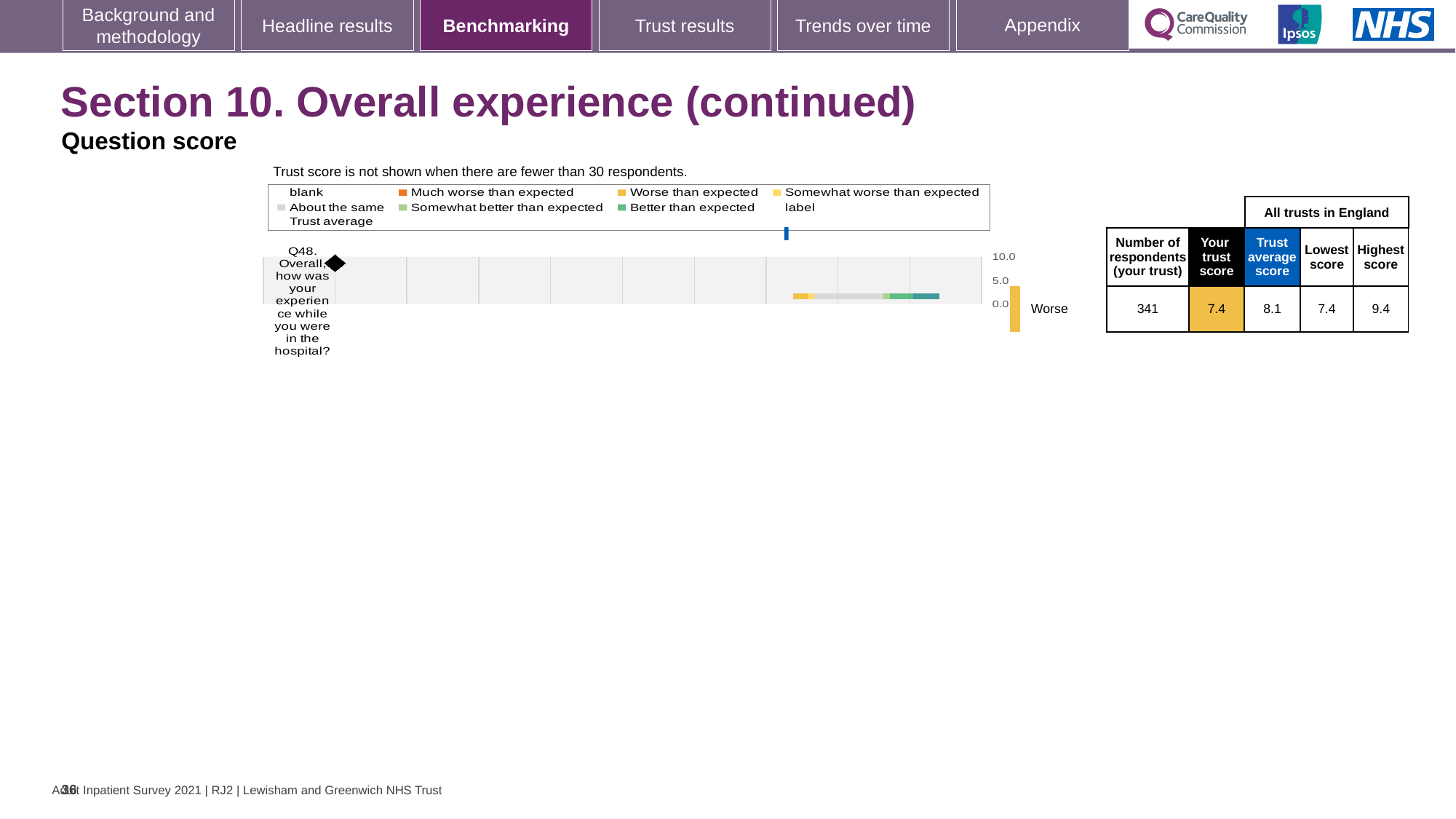
What is the lowest score among all trusts in England for Q48? 7.4 What kind of chart is used to show the Q48 benchmarking result? bar chart By how much does the trust average score exceed your trust score for Q48? 0.7 What is your trust score for Q48? 7.4 What is the trust average score for Q48 across all trusts in England? 8.1 How many questions are plotted in the benchmarking chart? 1 Which is larger for Q48: your trust score or the trust average score? Trust average score What colour represents 'Much worse than expected' in the chart legend? orange Below how many respondents is the trust score not shown, according to the note above the chart? 30 What is the highest score among all trusts in England for Q48? 9.4 What is the difference between the highest score and the lowest score for Q48? 2.0 What is the number of respondents (your trust) shown for Q48? 341